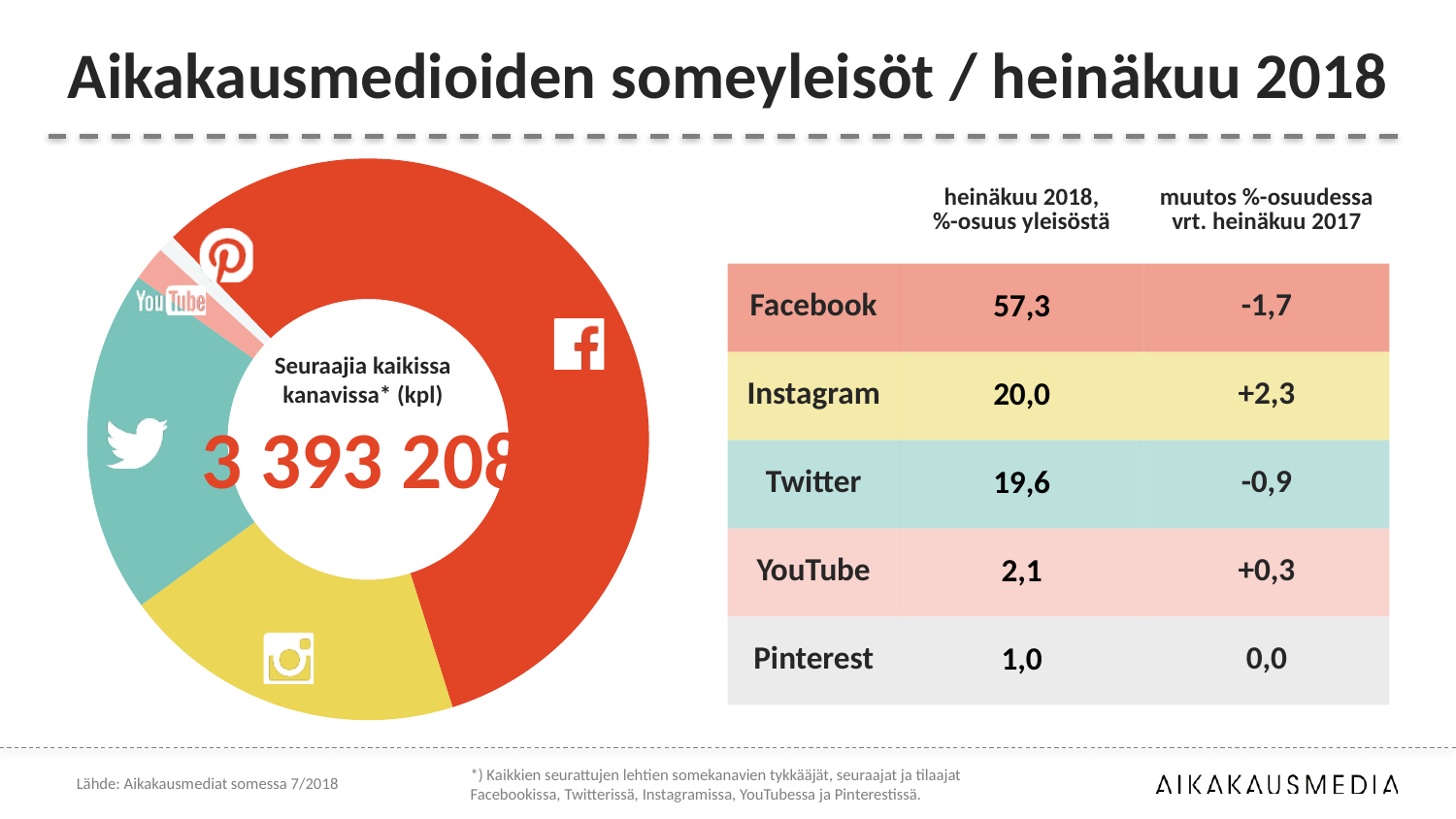
Which channel has the largest slice of the donut chart? Facebook What is the change in Twitter's share compared with July 2017 (muutos %-osuudessa vrt. heinäkuu 2017)? -0,9 How many social media channels are shown as slices in the donut chart? 5 What is the change in YouTube's share compared with July 2017? +0,3 Which channel has the larger share of the audience in July 2018, Instagram or Twitter? Instagram Which channel has the smallest slice of the donut chart? Pinterest What kind of chart is shown on the left of the slide? Pie (donut) chart What is Instagram's share of the audience in July 2018? 20,0 Which channel shows the largest positive change in share compared with July 2017? Instagram What total number of followers across all channels is printed in the centre of the donut chart? 3 393 208 What is Facebook's share of the audience in July 2018 (heinäkuu 2018, %-osuus yleisöstä)? 57,3 What is the difference in percentage points between Facebook's and Instagram's share of the audience in July 2018? 37,3